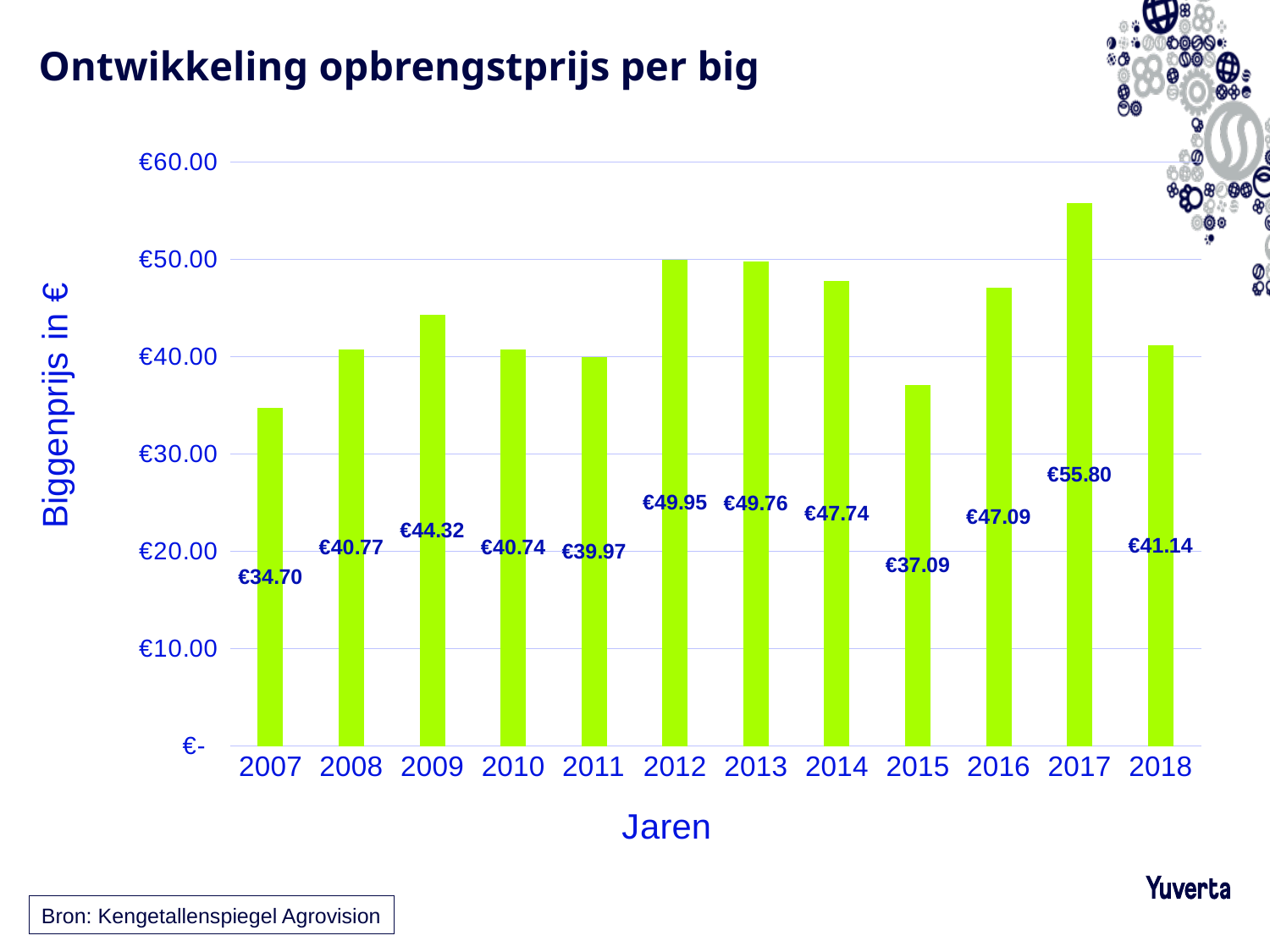
How many years are shown on the x axis? 12 Which year has the highest value? 2017 What is the difference between the values for 2017 and 2007? €21.10 What is the value for 2007? €34.70 What is the value for 2015? €37.09 Which is larger, the value for 2014 or the value for 2016? 2014 What is the difference between the values for 2012 and 2011? €9.98 Is the value for 2009 greater or less than €40.00? greater Do the values rise or fall from 2012 to 2015? fall What kind of chart is shown on the slide? bar chart What is the value for 2017? €55.80 Which year has the lowest value? 2007